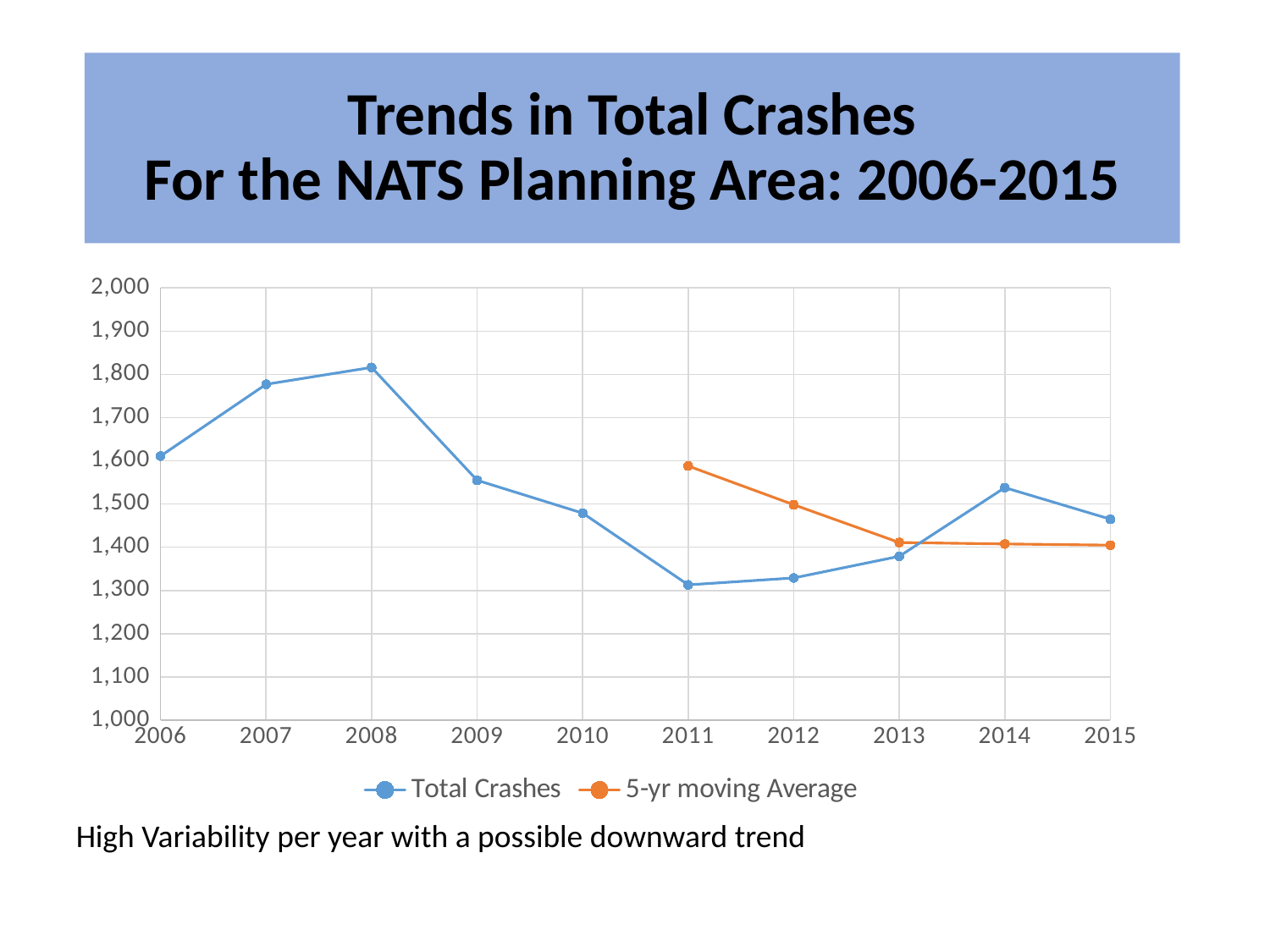
What is the first year for which the 5-yr moving Average is plotted? 2011 How many years are plotted on the x axis? 10 How many series does the legend list? 2 Does the 5-yr moving Average rise or fall from 2011 to 2015? Fall Does the Total Crashes series rise or fall from 2008 to 2011? Fall Is the 5-yr moving Average value for 2011 greater or less than 1,500? greater Is the Total Crashes value for 2011 greater or less than 1,400? less What kind of chart is shown on the slide? Line chart In which year is the Total Crashes value highest? 2008 Which year has the larger Total Crashes value, 2007 or 2009? 2007 Is the Total Crashes value for 2006 greater or less than 1,500? greater In 2014, which series has the larger value, Total Crashes or 5-yr moving Average? Total Crashes